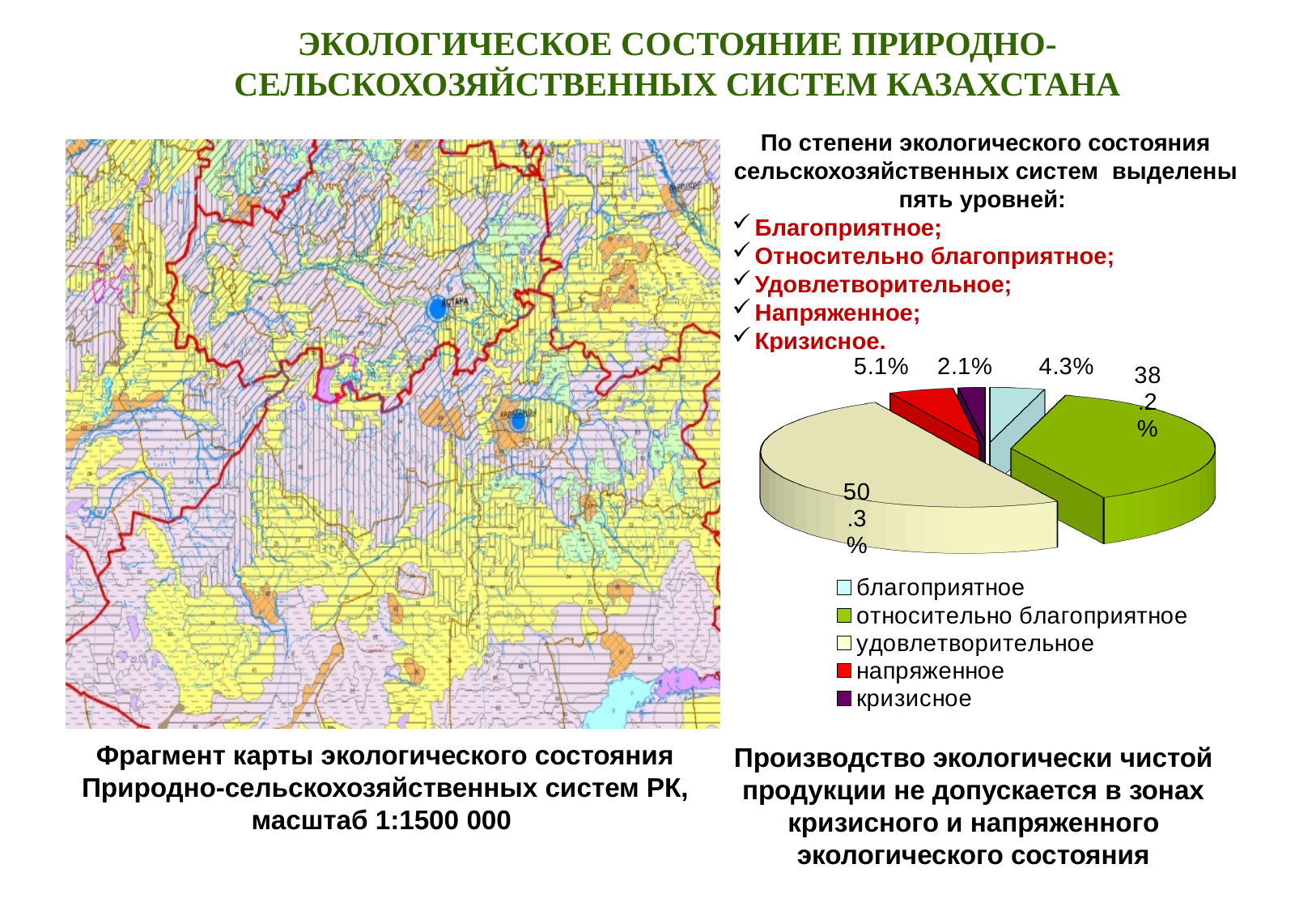
What is the value for "кризисное" in the pie chart? 2.1% What is the difference between the shares of "удовлетворительное" and "относительно благоприятное" in the pie chart? 12.1% Which category has the largest share in the pie chart? удовлетворительное What is the value for "напряженное" in the pie chart? 5.1% How many entries does the legend of the pie chart list? 5 What is the value for "благоприятное" in the pie chart? 4.3% Which category has the smallest share in the pie chart? кризисное How many slices does the pie chart have? 5 What type of chart is shown on the right side of the slide? pie chart What is the value for "удовлетворительное" in the pie chart? 50.3% Which is larger in the pie chart, "напряженное" or "благоприятное"? напряженное What is the value for "относительно благоприятное" in the pie chart? 38.2%